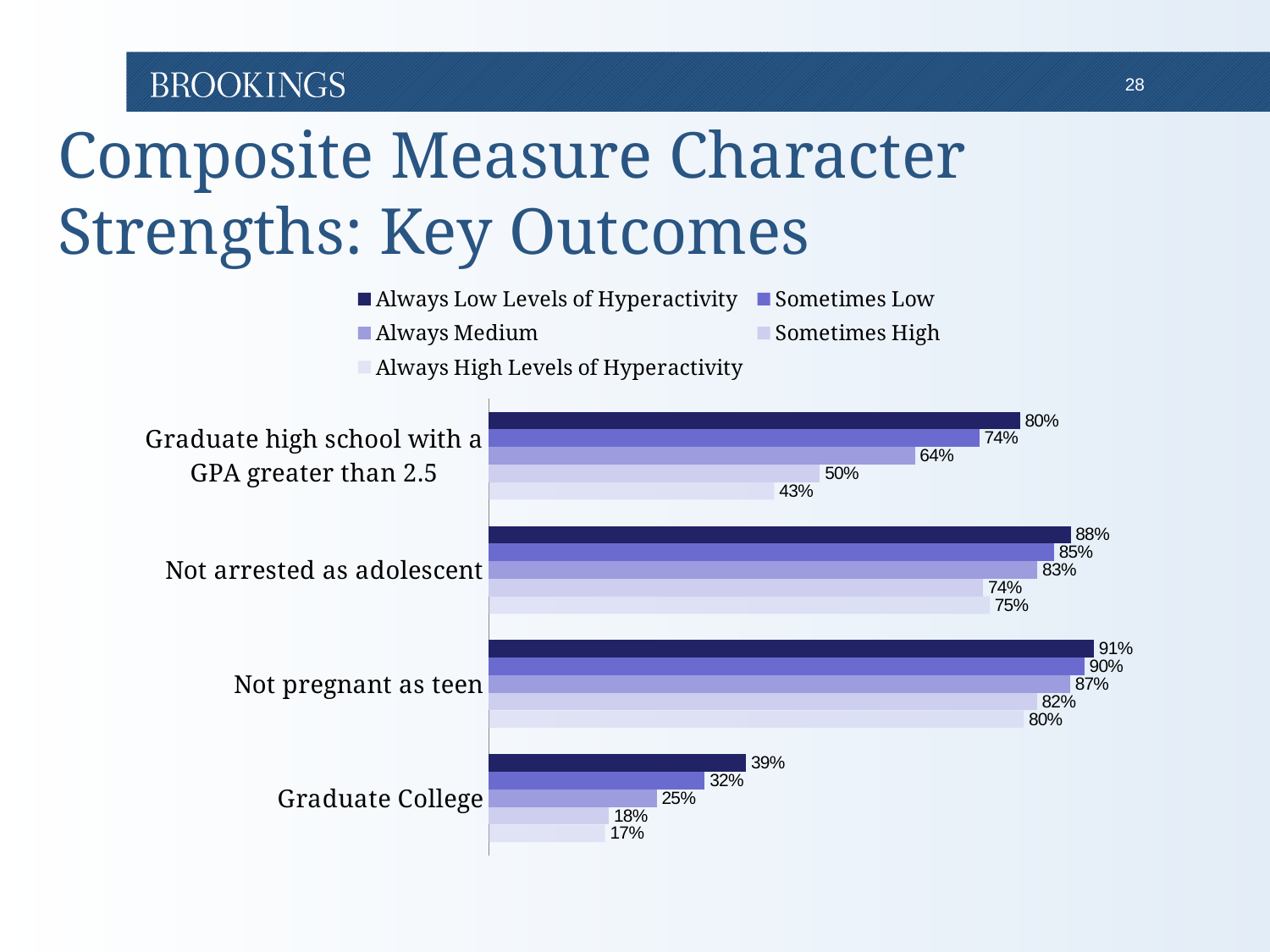
What is the value for Sometimes High for Not arrested as adolescent? 74% What is the value for Always Low Levels of Hyperactivity for Graduate high school with a GPA greater than 2.5? 80% Which outcome has the highest value for Always Low Levels of Hyperactivity? Not pregnant as teen What is the difference between the Always Low Levels of Hyperactivity and Always High Levels of Hyperactivity values for Graduate College? 22% What is the value for Always Medium for Not pregnant as teen? 87% How many series does the legend list? 5 Which is larger for Graduate high school with a GPA greater than 2.5: Sometimes Low or Always Medium? Sometimes Low What is the title of the slide containing the chart? Composite Measure Character Strengths: Key Outcomes How many outcome categories are shown on the chart? 4 What kind of chart is shown on the slide? Bar chart Which outcome has the lowest value for Sometimes Low? Graduate College What is the value for Always High Levels of Hyperactivity for Graduate College? 17%